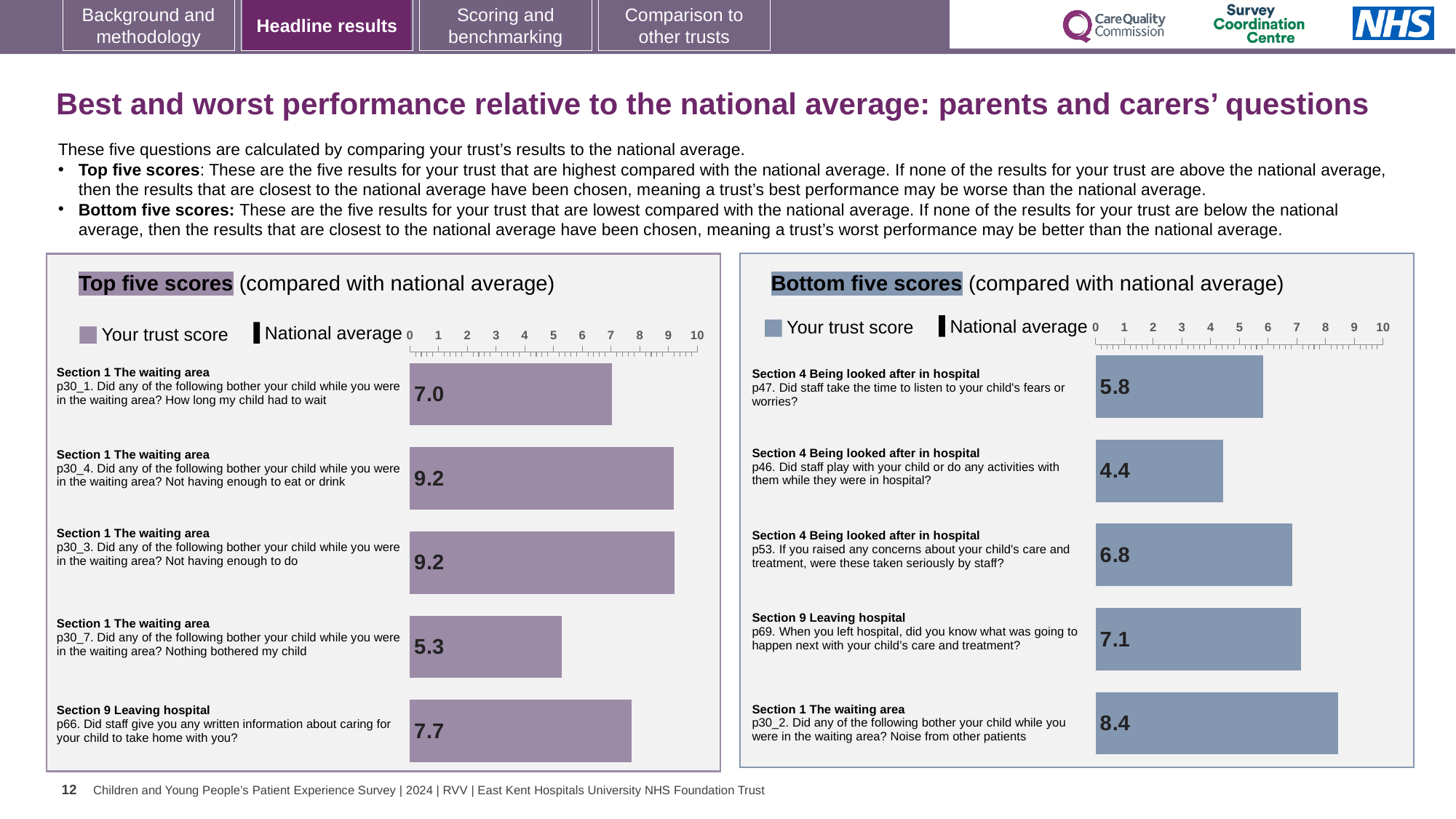
In the Top five scores chart, what is the trust score for p66 (written information about caring for your child to take home)? 7.7 How many series does the legend of the Bottom five scores chart list? 2 In the Bottom five scores chart, what is the difference between the trust scores for p30_2 and p46? 4.0 In the Bottom five scores chart, what is the trust score for p46 (Did staff play with your child or do any activities)? 4.4 In the Top five scores chart, which question has the lowest trust score? p30_7. Nothing bothered my child In the Bottom five scores chart, which question has the lowest trust score? p46. Did staff play with your child or do any activities with them while they were in hospital? What type of chart is used in the Top five scores panel? Bar chart In the Top five scores chart, how many questions are plotted? 5 In the Bottom five scores chart, which is larger: the trust score for p47 or for p53? p53 In the Bottom five scores chart, which question has the highest trust score? p30_2. Noise from other patients In the Top five scores chart, what is the trust score for p30_1 (How long my child had to wait)? 7.0 In the Top five scores chart, what is the difference between the trust scores for p30_4 and p30_7? 3.9